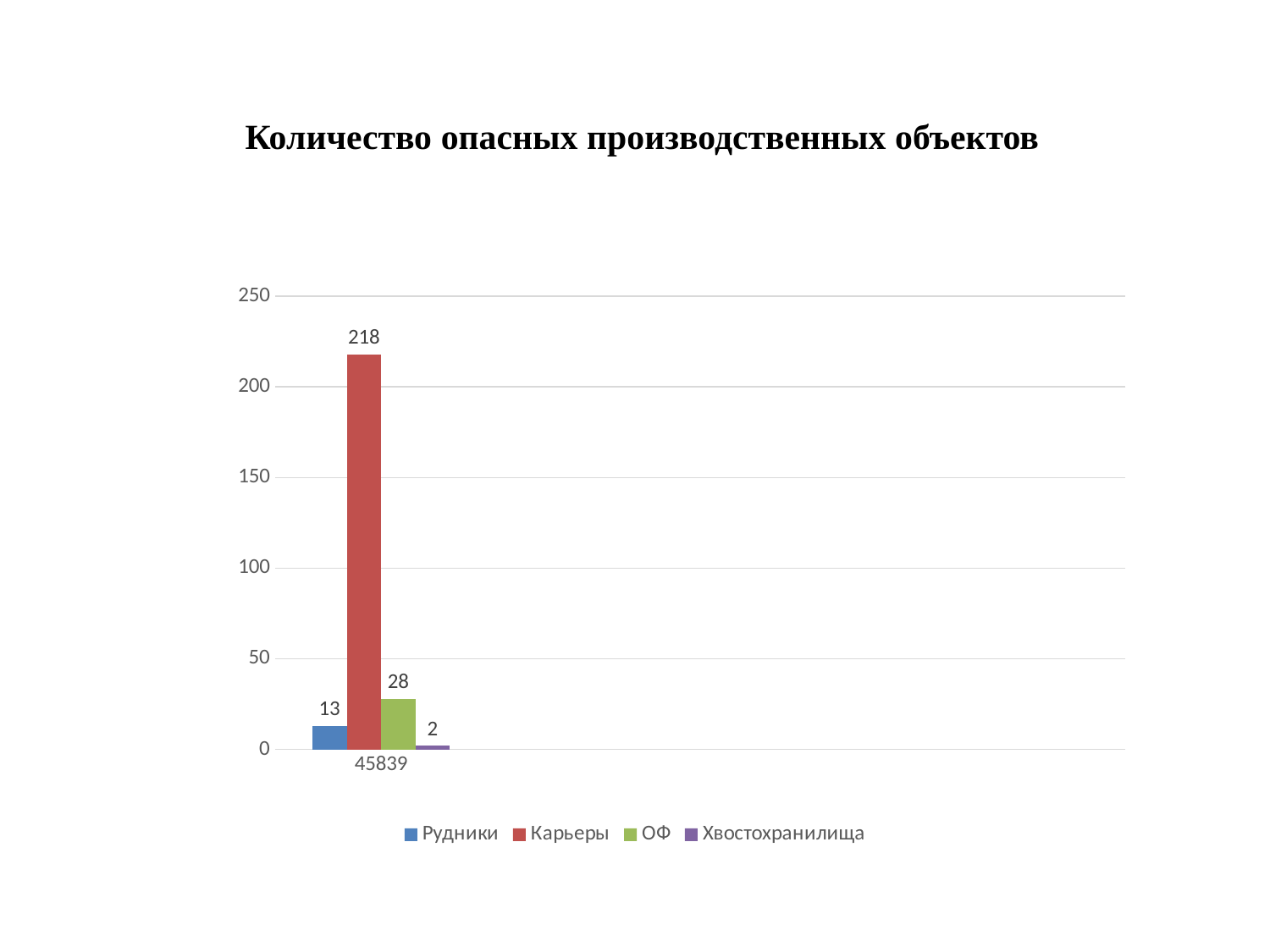
What is the difference between the values for ОФ and Рудники? 15 What is the value for Хвостохранилища? 2 What kind of chart is shown on the slide? Bar chart What is the value for Карьеры? 218 Which series has the highest value? Карьеры What is the value for Рудники? 13 What is the difference between the values for Карьеры and ОФ? 190 What is the title of the chart? Количество опасных производственных объектов How many series does the legend list? 4 Which is larger, the value for Рудники or the value for ОФ? ОФ Which series has the lowest value? Хвостохранилища What is the value for ОФ? 28